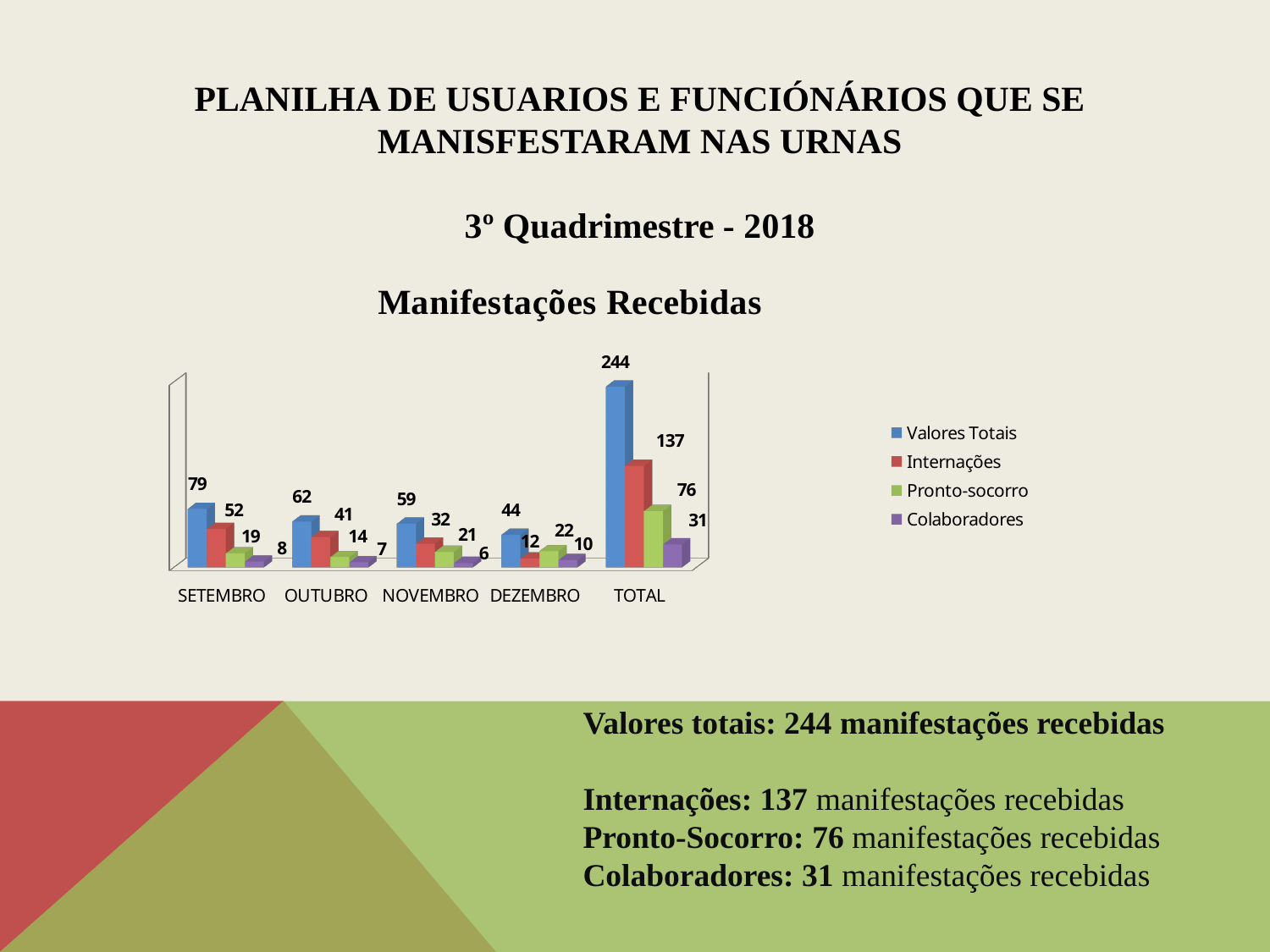
What is the value of Valores Totais for SETEMBRO? 79 Which month (excluding TOTAL) has the highest Valores Totais? SETEMBRO How many series does the legend list? 4 What kind of chart is shown? bar chart Which month (excluding TOTAL) has the lowest Internações value? DEZEMBRO What is the value of Colaboradores for NOVEMBRO? 6 What is the title of the chart? Manifestações Recebidas Which is larger, Pronto-socorro for NOVEMBRO or Pronto-socorro for DEZEMBRO? DEZEMBRO How many categories are shown on the x axis? 5 What is the difference between Valores Totais for SETEMBRO and OUTUBRO? 17 What is the value of Internações for OUTUBRO? 41 What is the value of Pronto-socorro for DEZEMBRO? 22